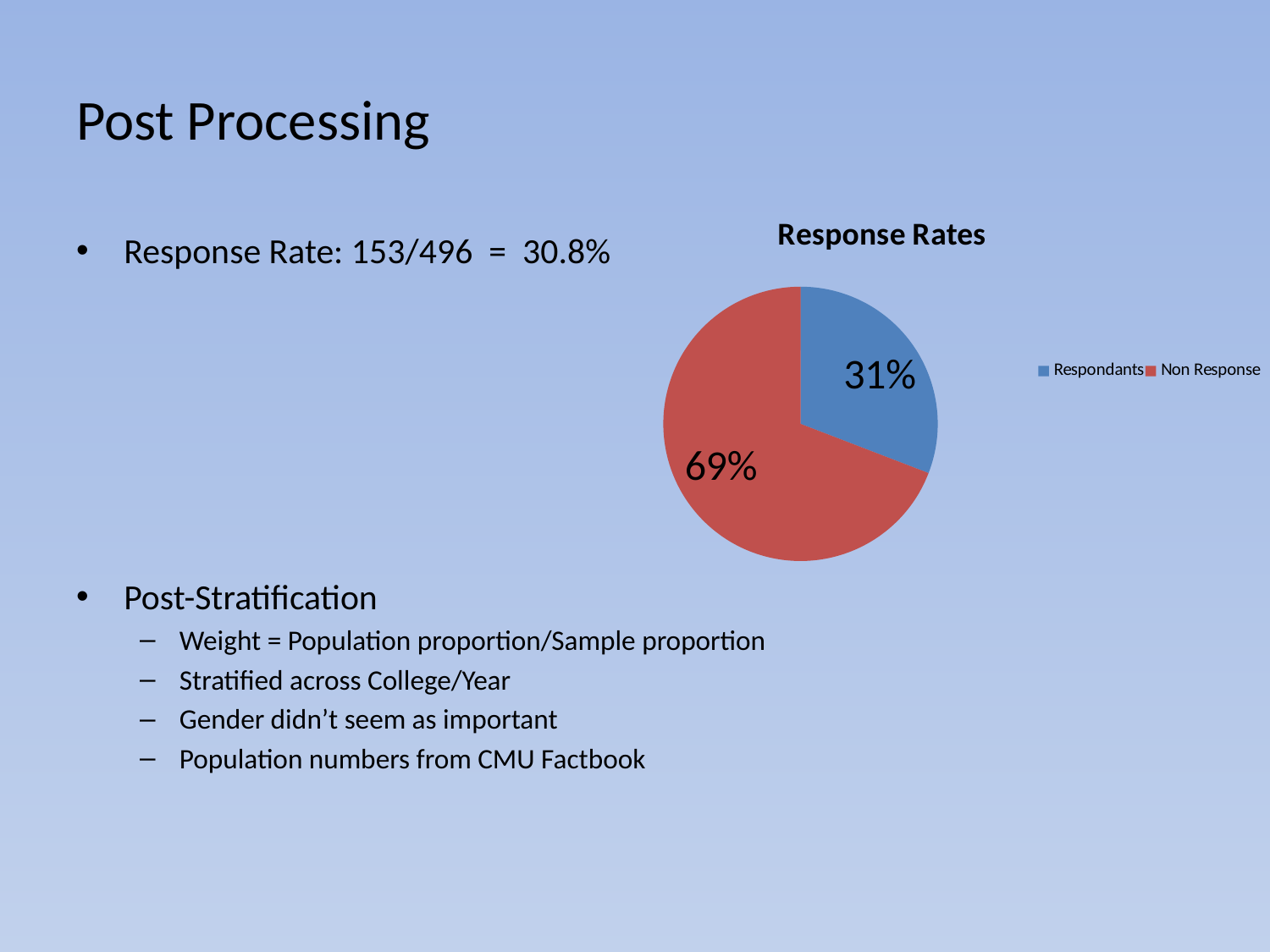
Which slice of the pie is the largest? Non Response How many entries does the legend list? 2 What share of the pie is Respondants? 31% What kind of chart is shown on the slide? pie chart Which slice of the pie is the smallest? Respondants What colour is the Non Response slice? red Which is larger, the Respondants slice or the Non Response slice? Non Response What is the title of the chart? Response Rates What share of the pie is Non Response? 69% How many slices does the pie chart have? 2 What is the difference in percentage points between the Non Response and Respondants slices? 38%